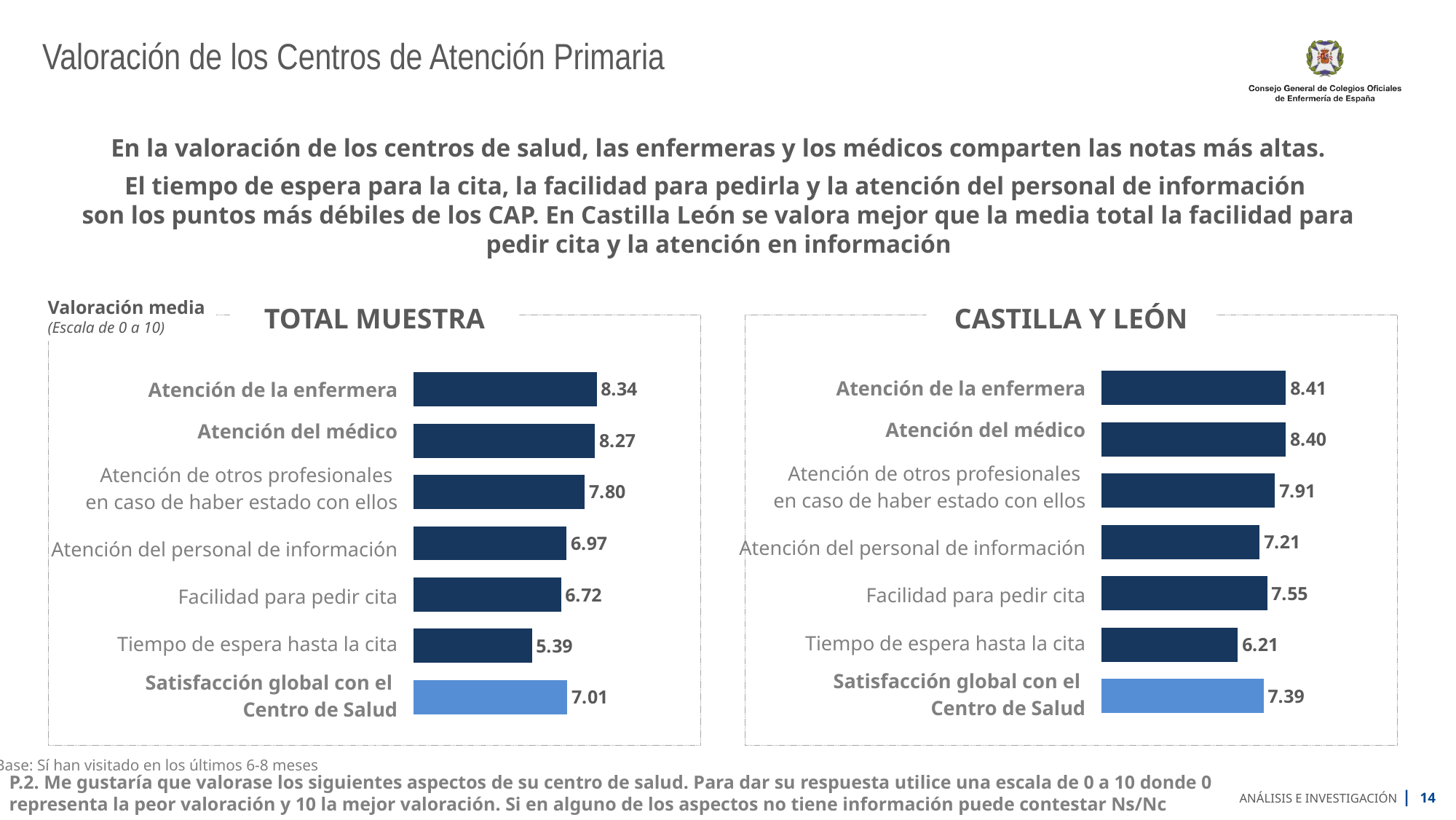
In the CASTILLA Y LEÓN chart, which category has the highest value? Atención de la enfermera In the TOTAL MUESTRA chart, which is larger: Atención del personal de información or Facilidad para pedir cita? Atención del personal de información What scale is used for the values in the charts, according to the note next to 'Valoración media'? Escala de 0 a 10 In the TOTAL MUESTRA chart, which category has the lowest value? Tiempo de espera hasta la cita How many categories are shown in the CASTILLA Y LEÓN chart? 7 What is the difference between the Facilidad para pedir cita value in the CASTILLA Y LEÓN chart and in the TOTAL MUESTRA chart? 0.83 In the CASTILLA Y LEÓN chart, what is the value for Facilidad para pedir cita? 7.55 In the TOTAL MUESTRA chart, which bar is shown in a lighter blue colour than the others? Satisfacción global con el Centro de Salud In the TOTAL MUESTRA chart, what is the value for Atención de la enfermera? 8.34 In the CASTILLA Y LEÓN chart, what is the value for Satisfacción global con el Centro de Salud? 7.39 What kind of chart is the TOTAL MUESTRA chart? Bar chart In the TOTAL MUESTRA chart, what is the difference between Atención de la enfermera and Tiempo de espera hasta la cita? 2.95